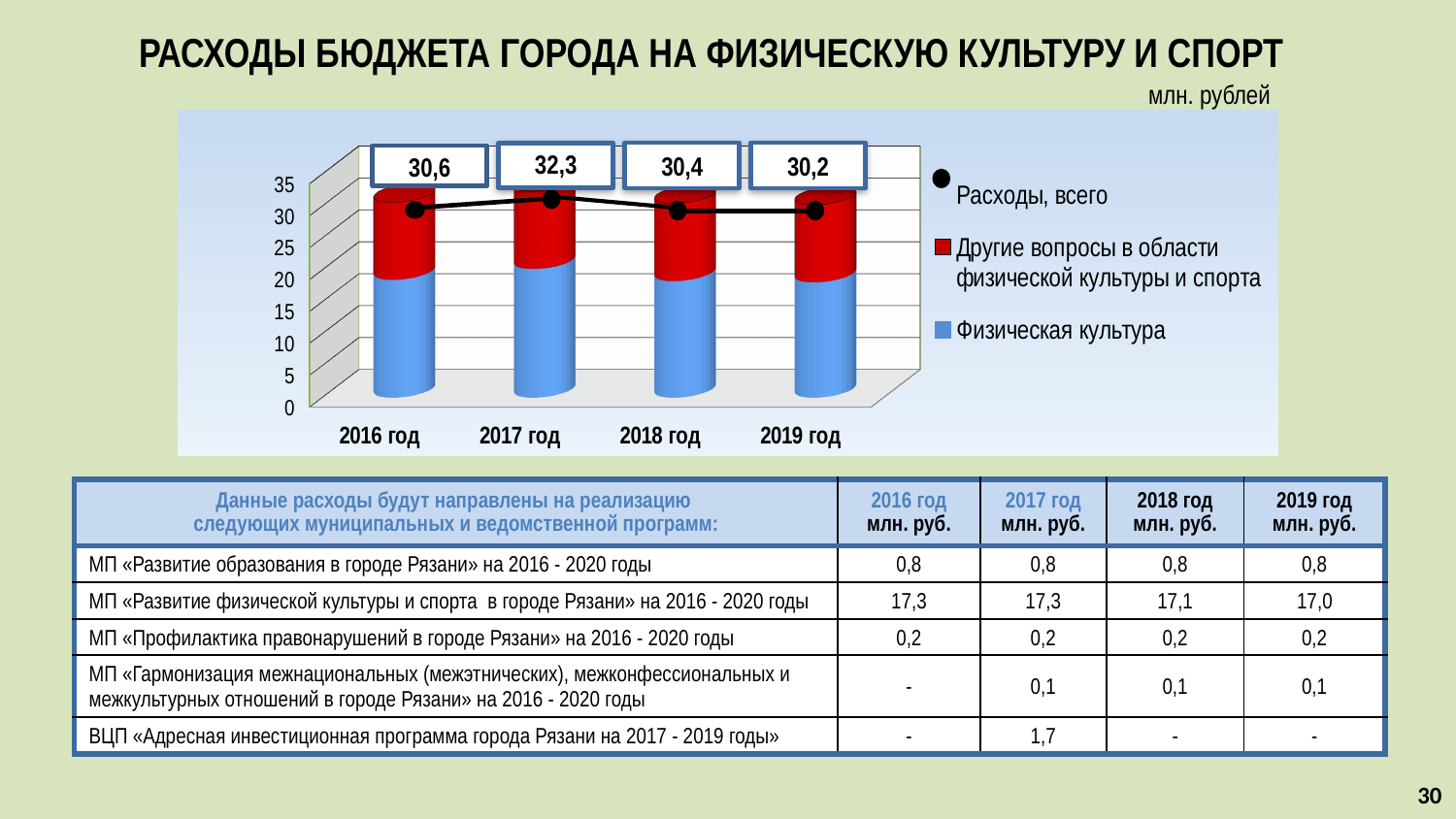
Which is larger, «Расходы, всего» in 2018 год or in 2019 год? 2018 год What is the value of «Расходы, всего» for 2019 год? 30,2 Is the value of «Физическая культура» for 2019 год greater or less than 25? less How many years are shown on the x axis of the chart? 4 In which year is «Расходы, всего» the highest? 2017 год How many entries does the chart legend list? 3 In which year is «Расходы, всего» the lowest? 2019 год What is the value of «Расходы, всего» for 2016 год? 30,6 Is the value of «Физическая культура» for 2016 год greater or less than 15? greater What kind of chart is shown on the slide? Stacked bar chart with a line What is the value of «Расходы, всего» for 2017 год? 32,3 What is the difference between «Расходы, всего» in 2017 год and 2016 год? 1,7